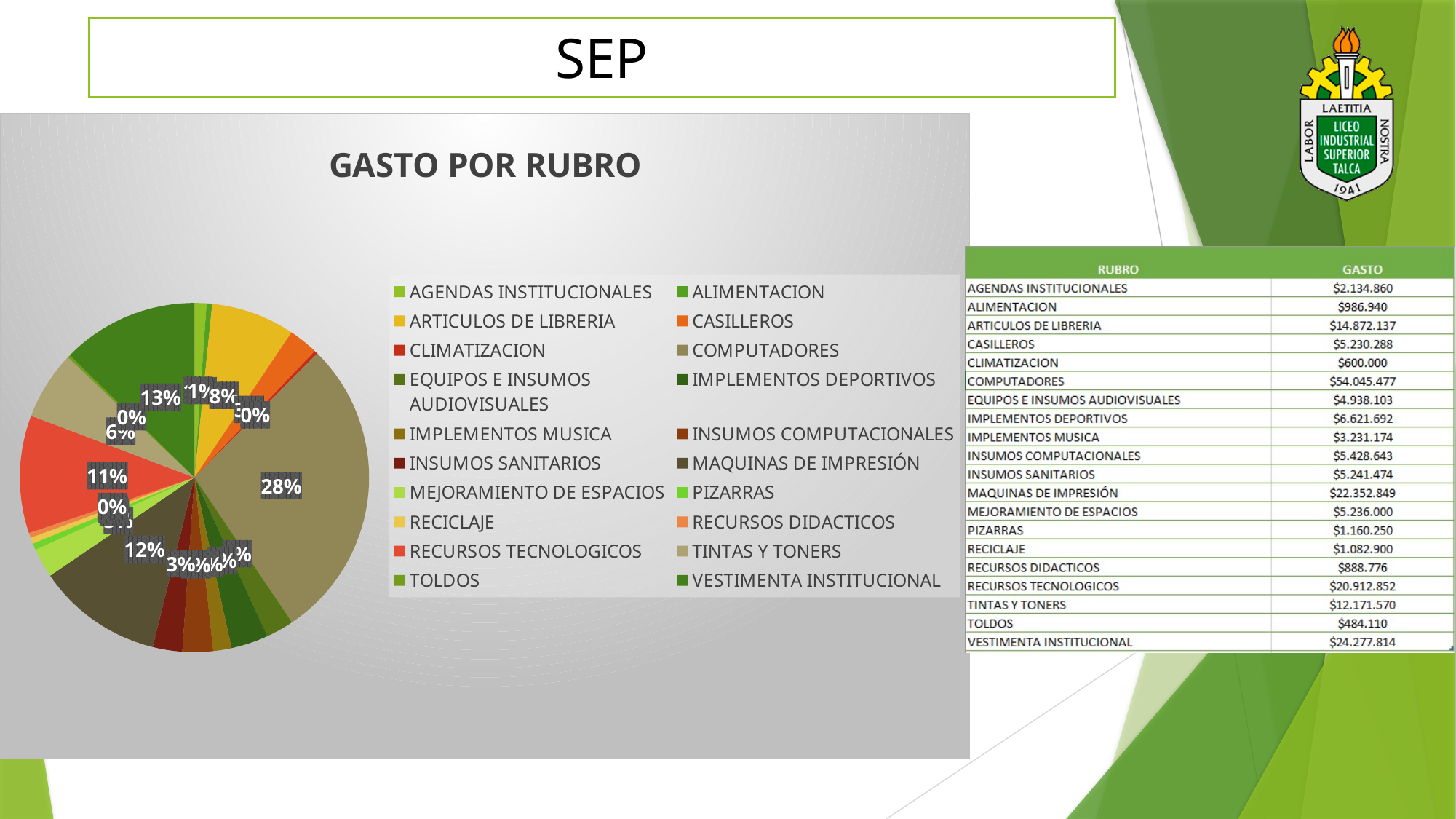
What share of the pie does VESTIMENTA INSTITUCIONAL represent? 13% What share of the pie does TINTAS Y TONERS represent? 6% What kind of chart is shown under the title GASTO POR RUBRO? pie chart Which slice is larger in the pie chart, COMPUTADORES or VESTIMENTA INSTITUCIONAL? COMPUTADORES What is the title of the pie chart? GASTO POR RUBRO What share of the pie does RECURSOS TECNOLOGICOS represent? 11% How many categories does the legend of the GASTO POR RUBRO pie chart list? 20 Which category has the largest slice in the GASTO POR RUBRO pie chart? COMPUTADORES By how many percentage points does the COMPUTADORES share exceed the VESTIMENTA INSTITUCIONAL share in the pie chart? 15%